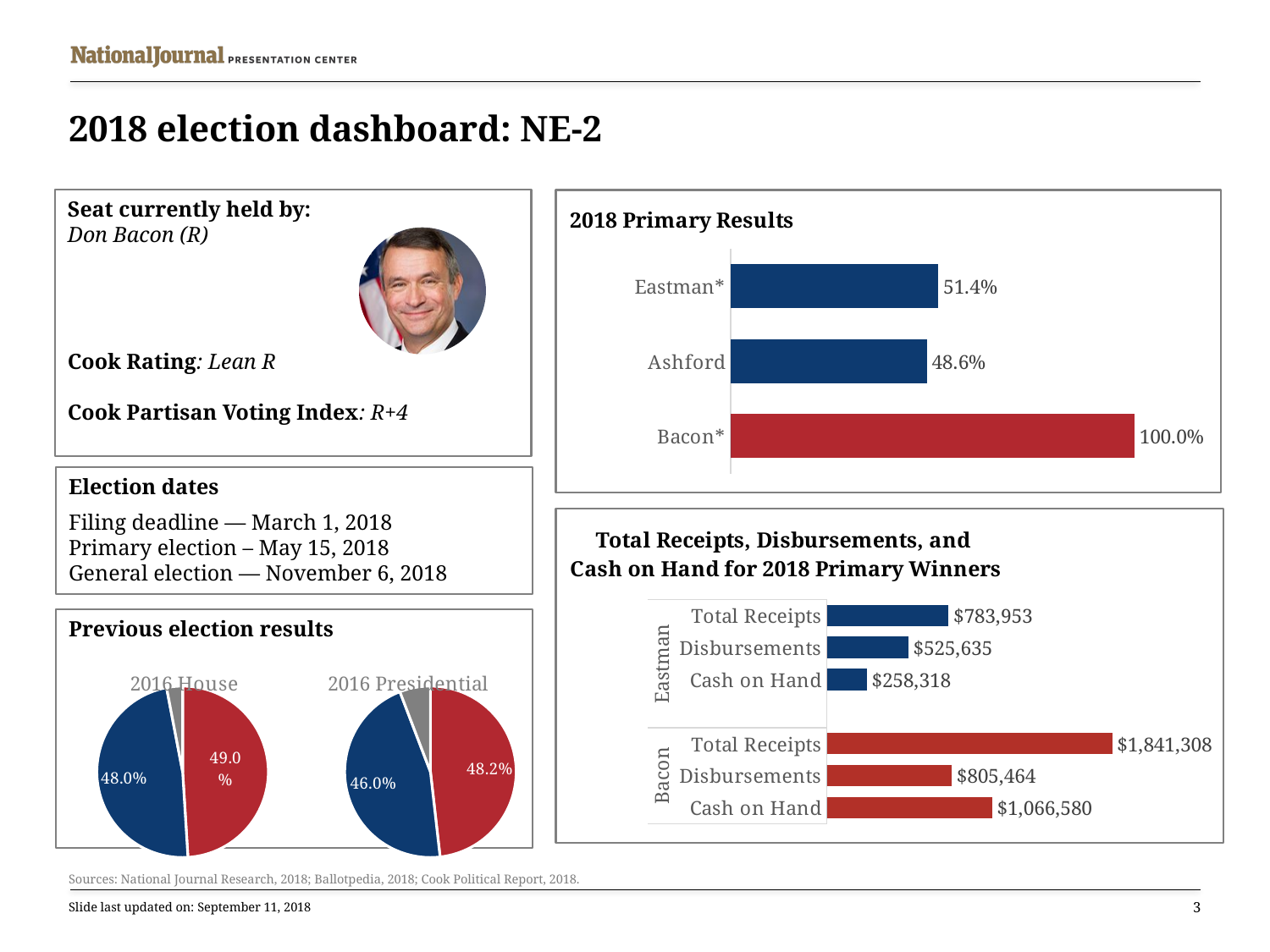
In the Total Receipts, Disbursements, and Cash on Hand chart, how much larger are Bacon's Total Receipts than Eastman's? $1,057,355 In the Total Receipts, Disbursements, and Cash on Hand chart, what is Eastman's Cash on Hand? $258,318 In the 2016 Presidential pie chart under Previous election results, what share does the red slice show? 48.2% In the 2018 Primary Results chart, what percentage did Eastman* receive? 51.4% In the Total Receipts, Disbursements, and Cash on Hand chart, which candidate has the larger Disbursements value? Bacon In the 2018 Primary Results chart, what is the difference in percentage points between Eastman* and Ashford? 2.8 In the 2016 House pie chart under Previous election results, what share does the blue slice show? 48.0% In the 2018 Primary Results chart, what percentage did Ashford receive? 48.6% In the 2018 Primary Results chart, which candidate has the highest value? Bacon* In the Total Receipts, Disbursements, and Cash on Hand chart, what is Bacon's Total Receipts value? $1,841,308 What type of chart is the 2018 Primary Results chart? bar chart How many candidates are shown in the 2018 Primary Results chart? 3